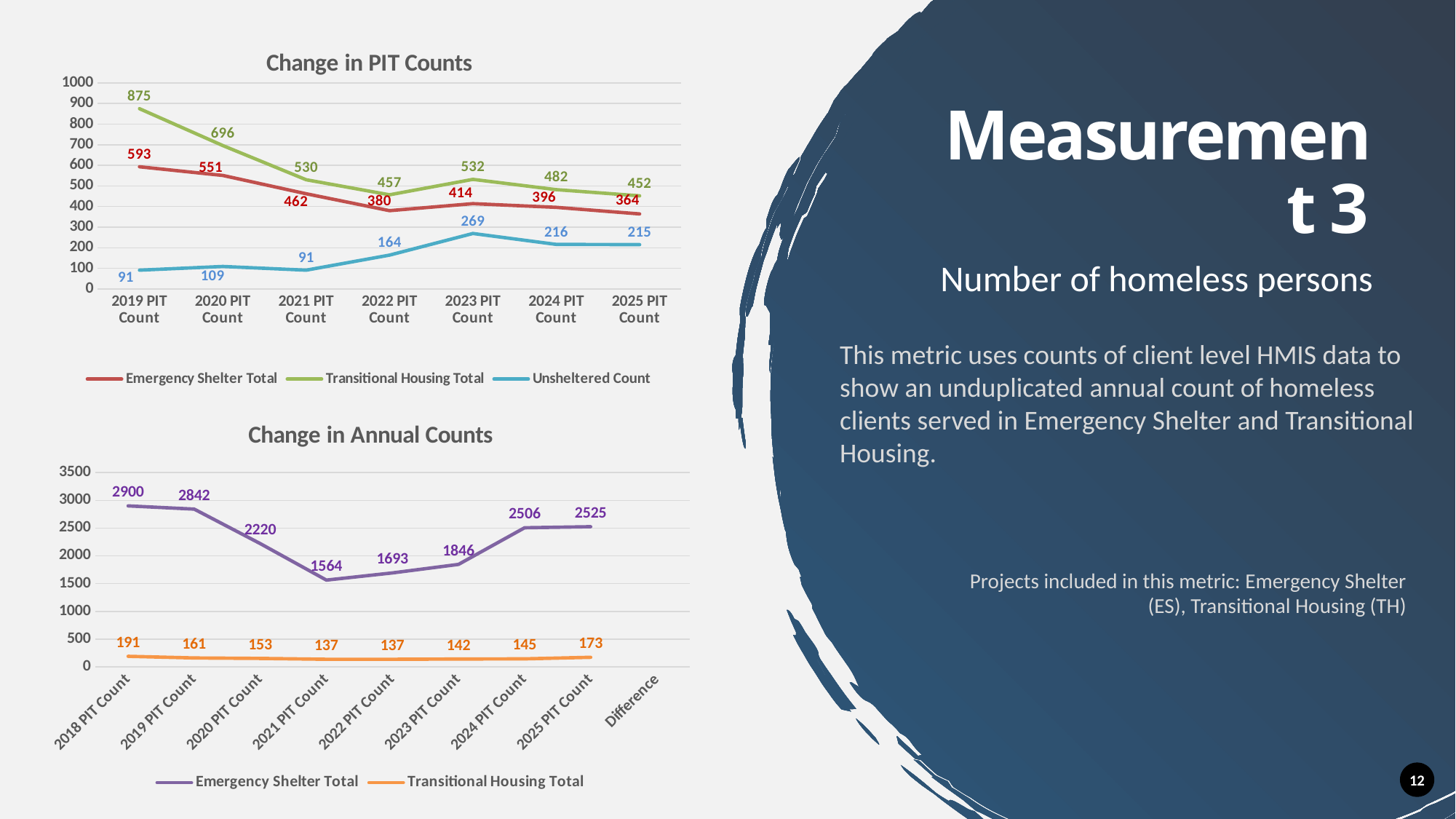
In the 'Change in Annual Counts' chart, what is the Emergency Shelter Total for the 2021 PIT Count? 1564 In the 'Change in PIT Counts' chart, what is the Transitional Housing Total for the 2019 PIT Count? 875 In the 'Change in Annual Counts' chart, which PIT count has the highest Emergency Shelter Total? 2018 PIT Count In the 'Change in PIT Counts' chart, which PIT count has the lowest Emergency Shelter Total? 2025 PIT Count In the 'Change in Annual Counts' chart, what is the difference between the Transitional Housing Total for the 2018 PIT Count and the 2025 PIT Count? 18 In the 'Change in Annual Counts' chart, does the Emergency Shelter Total rise or fall from the 2018 PIT Count to the 2021 PIT Count? Fall In the 'Change in PIT Counts' chart, which is larger for the 2022 PIT Count: the Transitional Housing Total or the Emergency Shelter Total? Transitional Housing Total In the 'Change in PIT Counts' chart, what is the Unsheltered Count for the 2023 PIT Count? 269 What kind of chart is 'Change in Annual Counts'? Line chart How many series does the legend of the 'Change in PIT Counts' chart list? 3 In the 'Change in PIT Counts' chart, what is the difference between the Emergency Shelter Total for the 2019 PIT Count and the 2025 PIT Count? 229 In the 'Change in Annual Counts' chart, which colour is used for the Transitional Housing Total line? Orange